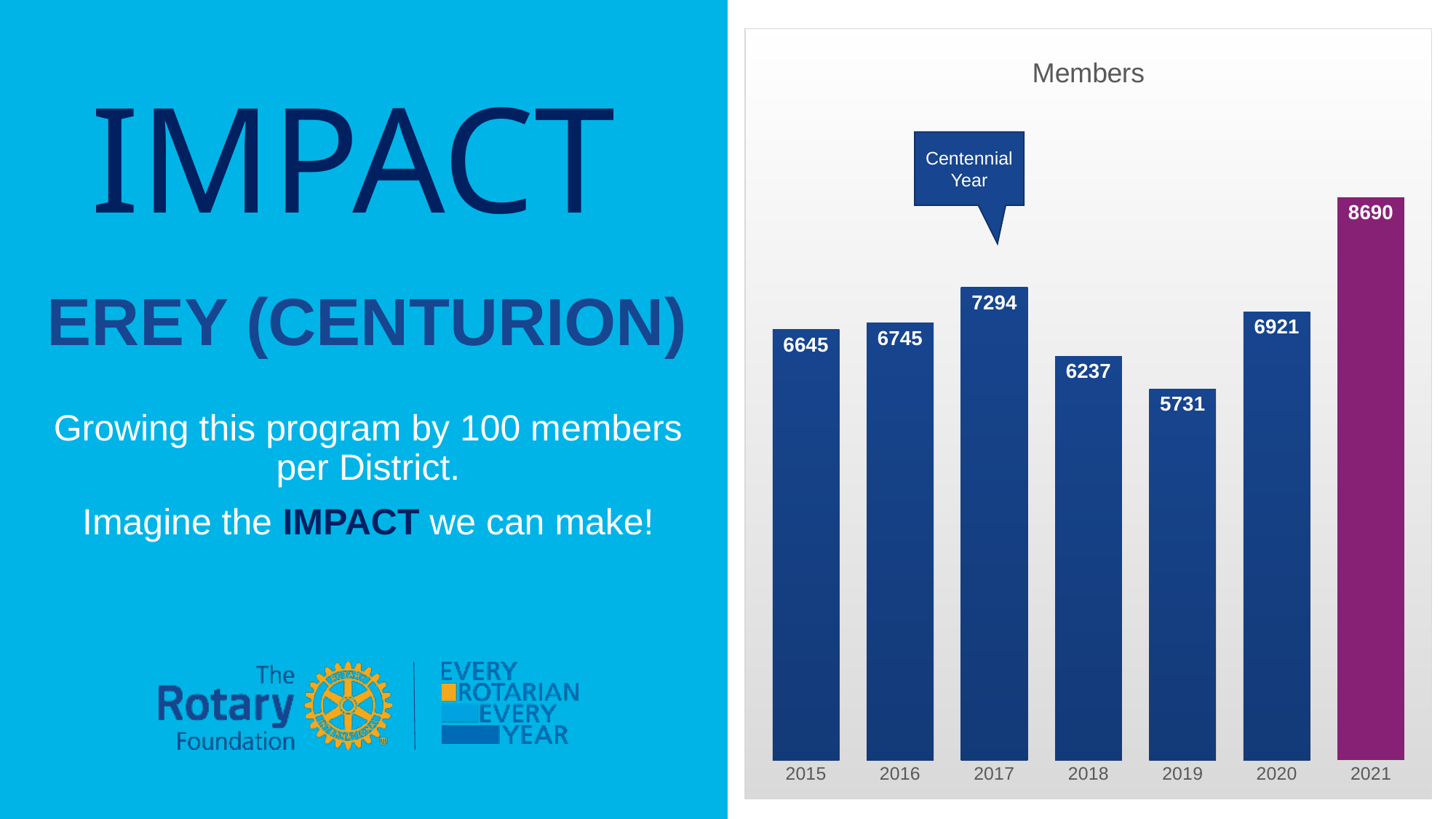
How many years are shown on the chart? 7 What is the title of the chart? Members What is the number of members shown for 2019? 5731 What is the number of members shown for 2021? 8690 What kind of chart is shown on the slide? Bar chart Which year has the lowest number of members? 2019 What is the difference in members between 2021 and 2020? 1769 What is the difference in members between 2017 and 2018? 1057 Which year has more members, 2016 or 2018? 2016 What is the number of members shown for 2017? 7294 Which year has the highest number of members? 2021 Which year is labelled with the callout 'Centennial Year'? 2017